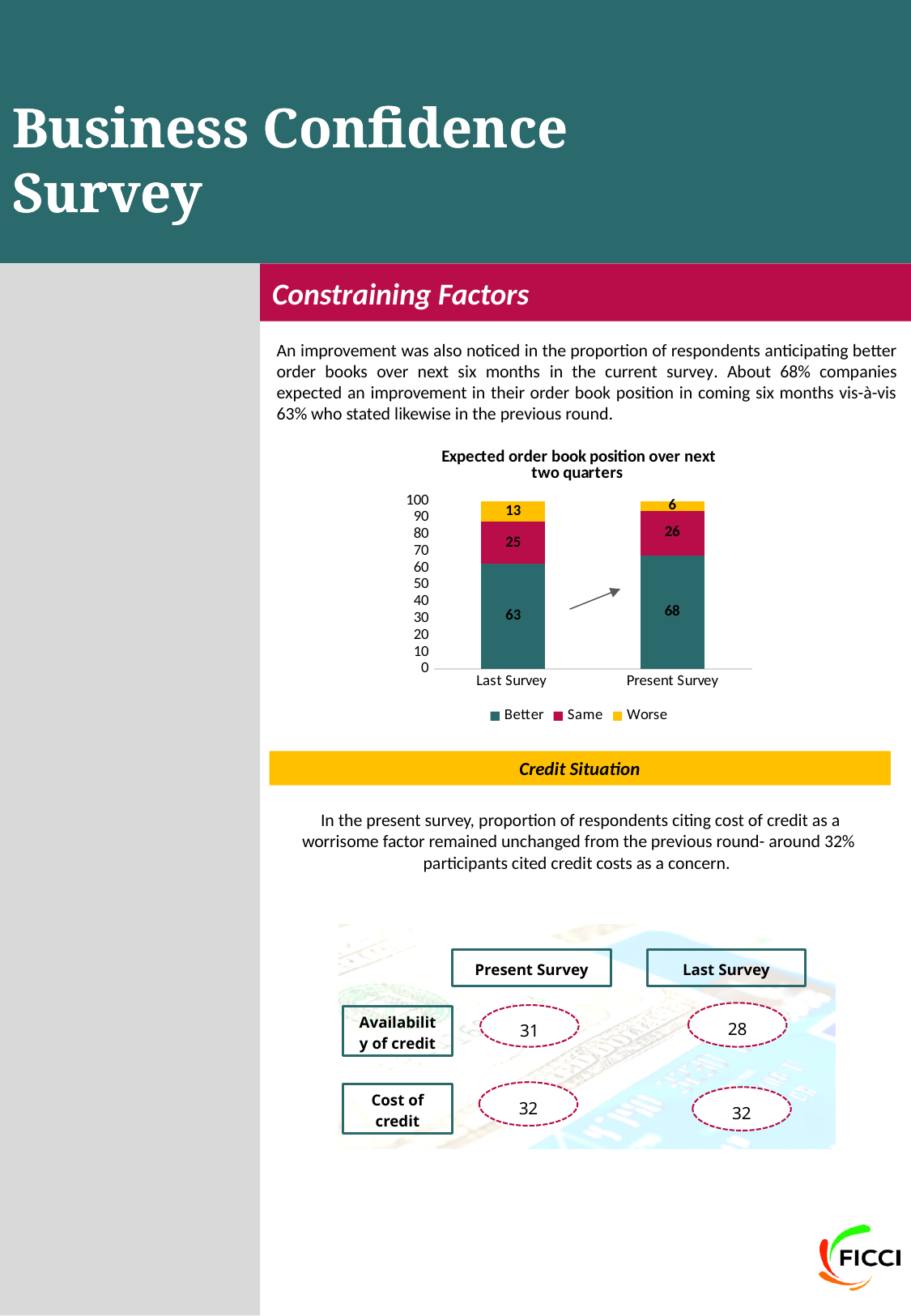
What is the total of the Last Survey stacked bar? 101 What is the value for Worse in the Last Survey bar? 13 What is the difference between the Better values for Present Survey and Last Survey? 5 How many series does the legend list? 3 What is the value for Worse in the Present Survey bar? 6 What is the title of the chart? Expected order book position over next two quarters What is the difference between the Worse values for Last Survey and Present Survey? 7 What kind of chart is shown? Stacked bar chart What is the total of the Present Survey stacked bar? 100 What is the value for Better in the Last Survey bar? 63 Which survey has the higher value for Better? Present Survey What is the value for Same in the Present Survey bar? 26